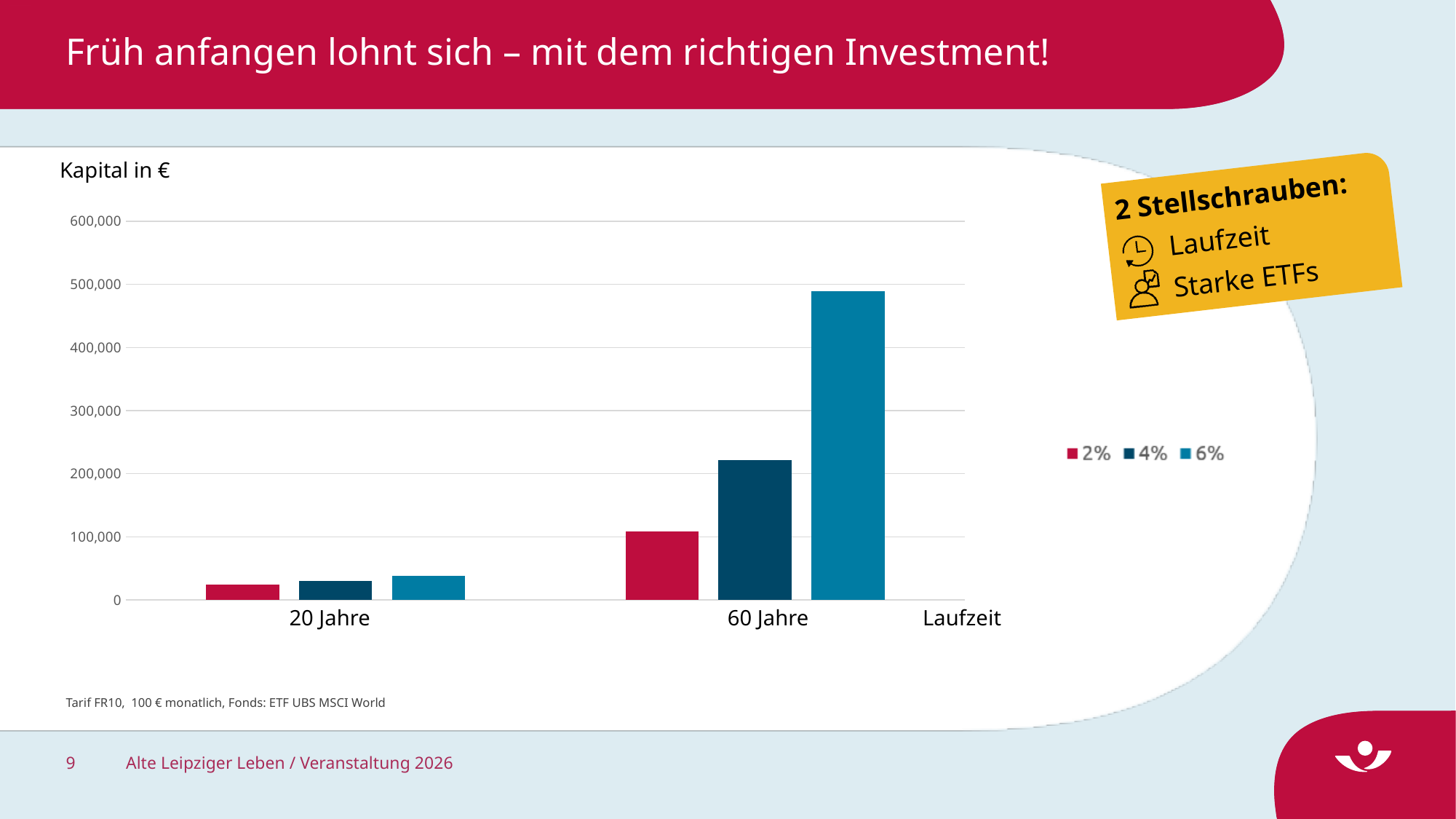
Which series has the highest bar for 60 Jahre? 6% Which series has the lowest bar for 20 Jahre? 2% Is the value for 6% at 20 Jahre greater or less than 100,000? less Is the value for 6% at 60 Jahre greater or less than 400,000? greater How many categories (Laufzeit values) are shown on the x axis? 2 How many series does the legend list? 3 Is the value for 4% at 60 Jahre greater or less than 200,000? greater Which is larger: the 6% bar at 60 Jahre or the 4% bar at 60 Jahre? 6% at 60 Jahre Do the values for each series rise or fall from 20 Jahre to 60 Jahre? rise What kind of chart is shown on the slide? bar chart What is the label of the y axis of the chart? Kapital in €